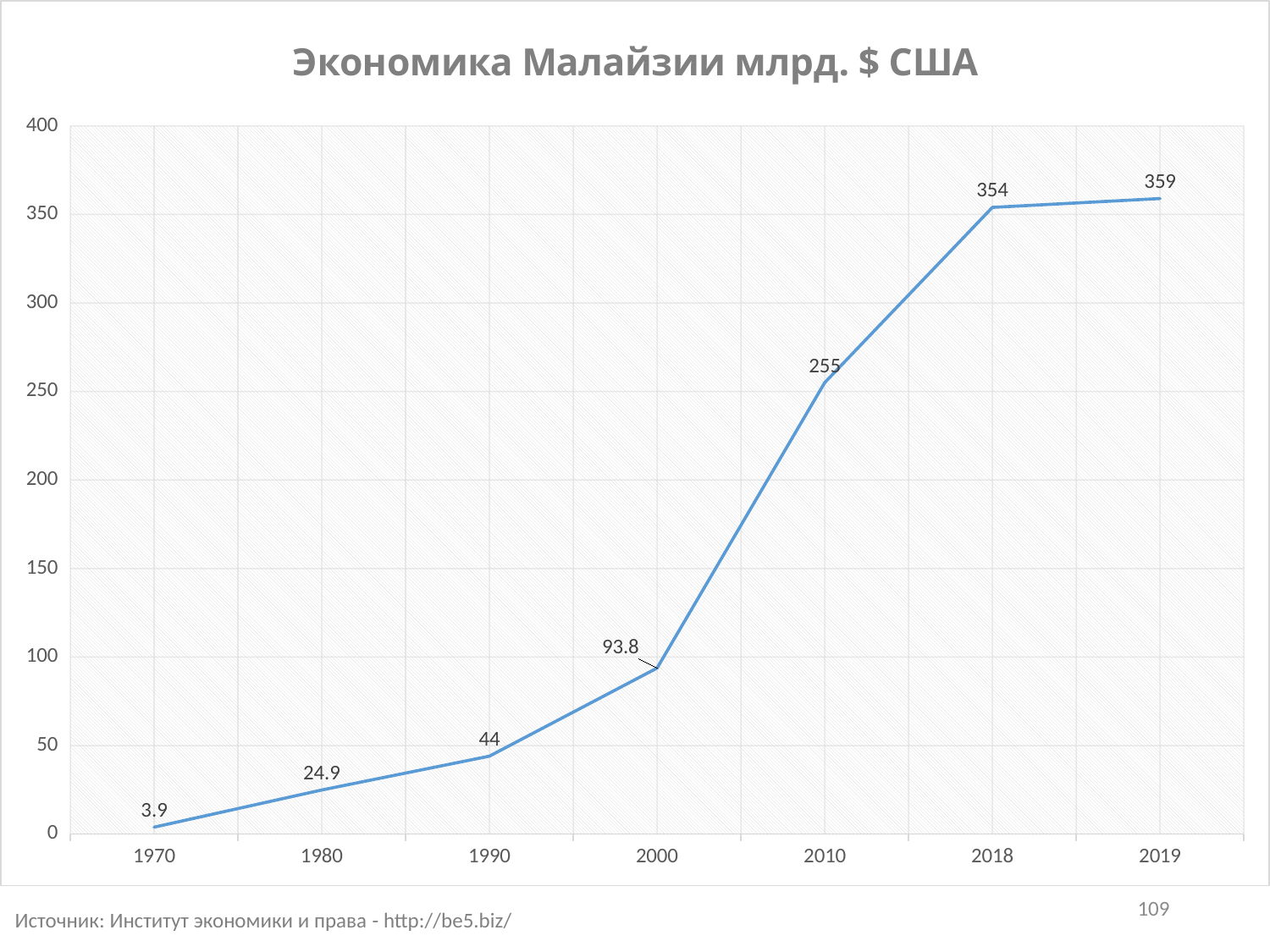
What is the value for 2000? 93.8 What is the value for 2010? 255 Which year has the highest value? 2019 How many data points are plotted on the chart? 7 What is the difference between the values for 2010 and 2000? 161.2 Which is larger, the value for 1990 or the value for 1980? 1990 What is the value for 1970? 3.9 What is the difference between the values for 2019 and 2018? 5 Which year has the lowest value? 1970 Is the value for 2018 greater or less than 300? greater What kind of chart is shown on the slide? line chart Do the values rise or fall from 1970 to 2019? rise